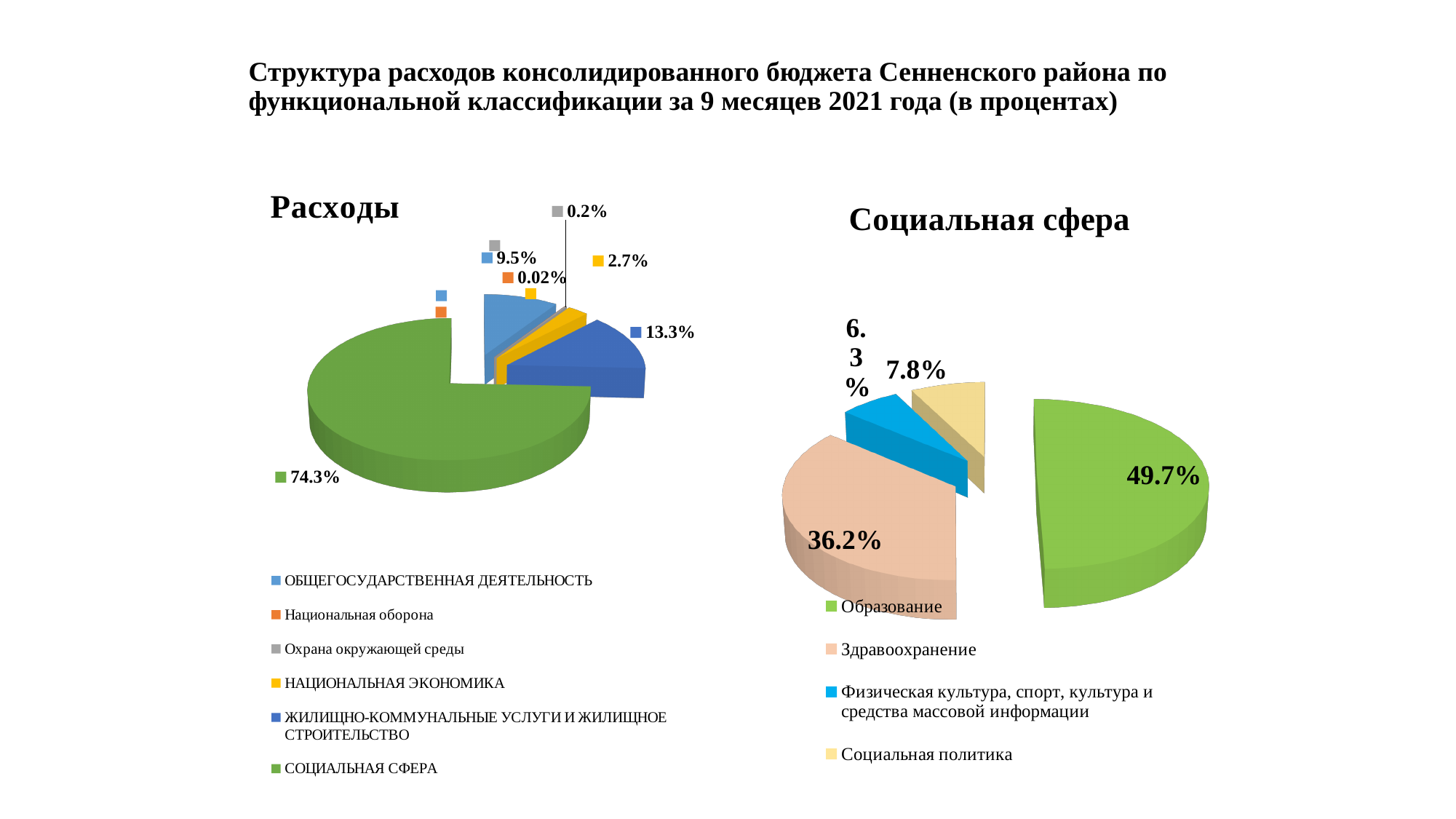
In the 'Расходы' pie chart, what is the difference between the shares of ОБЩЕГОСУДАРСТВЕННАЯ ДЕЯТЕЛЬНОСТЬ and НАЦИОНАЛЬНАЯ ЭКОНОМИКА? 6.8% In the 'Социальная сфера' pie chart, what share is shown for Социальная политика? 7.8% In the 'Расходы' pie chart, what share is shown for ЖИЛИЩНО-КОММУНАЛЬНЫЕ УСЛУГИ И ЖИЛИЩНОЕ СТРОИТЕЛЬСТВО? 13.3% In the 'Расходы' pie chart, what share is shown for Национальная оборона? 0.02% In the 'Расходы' pie chart, what share is shown for СОЦИАЛЬНАЯ СФЕРА? 74.3% In the 'Расходы' pie chart, which category has the smallest share? Национальная оборона What type of chart is the 'Социальная сфера' chart? Pie chart In the 'Социальная сфера' pie chart, what share is shown for Здравоохранение? 36.2% In the 'Расходы' pie chart, which category has the largest share? СОЦИАЛЬНАЯ СФЕРА In the 'Социальная сфера' pie chart, which is larger: Социальная политика or Физическая культура, спорт, культура и средства массовой информации? Социальная политика In the 'Социальная сфера' pie chart, which category has the largest share? Образование In the 'Расходы' pie chart, how many categories does the legend list? 6